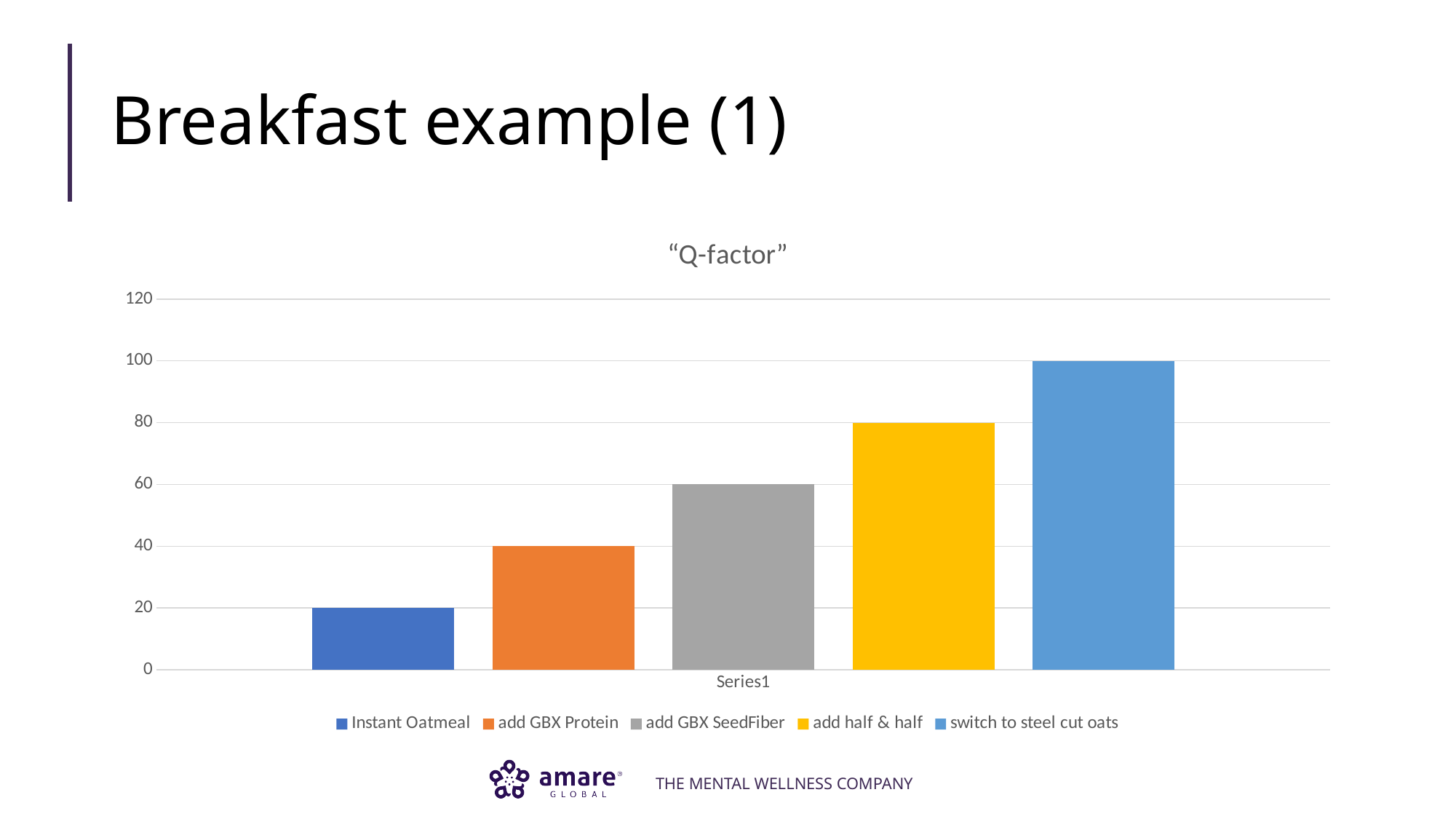
What is the value for switch to steel cut oats? 100 What type of chart is shown on the slide? Bar chart How many entries does the chart legend list? 5 What is the value for add GBX SeedFiber? 60 How many bars are plotted in the chart? 5 Which legend entry has the highest value? switch to steel cut oats What is the difference between the values for add half & half and Instant Oatmeal? 60 What is the value for add GBX Protein? 40 Do the bar values rise or fall from left to right across the chart? Rise What is the value for Instant Oatmeal? 20 Which legend entry has the lowest value? Instant Oatmeal What is the title of the chart? "Q-factor"